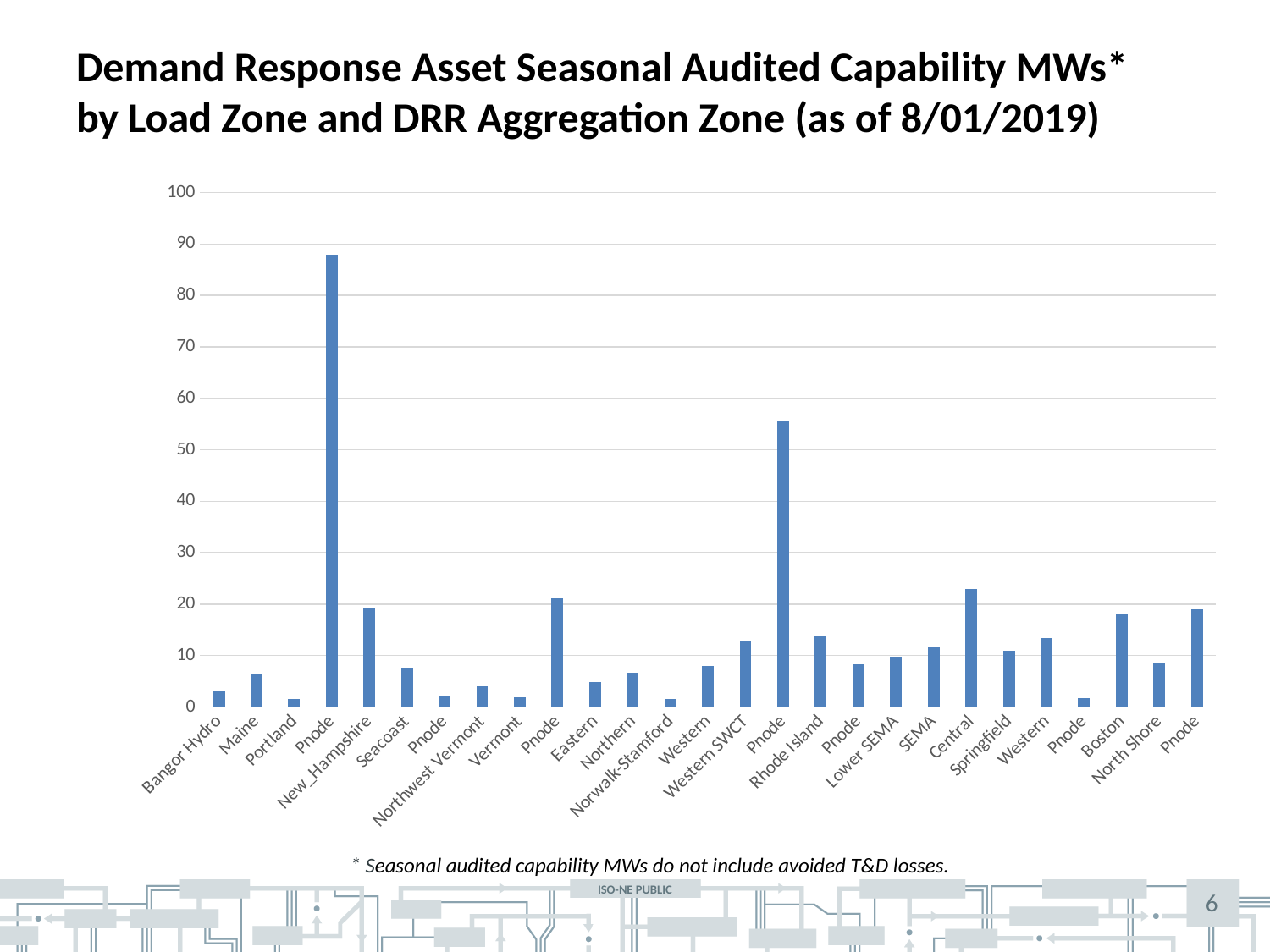
Which has the larger value, Maine or Bangor Hydro? Maine According to the footnote, what do the seasonal audited capability MWs not include? avoided T&D losses Which category has the tallest bar on the chart? Pnode Is the value for Rhode Island greater or less than 10? greater Which has the larger value, Central or Rhode Island? Central How many bars (categories) are plotted on the chart? 27 Which has the larger value, Boston or North Shore? Boston Is the value for the tallest bar (the Pnode bar after Portland) greater or less than 80? greater Is the value for Bangor Hydro greater or less than 10? less What kind of chart is shown on the slide? bar chart